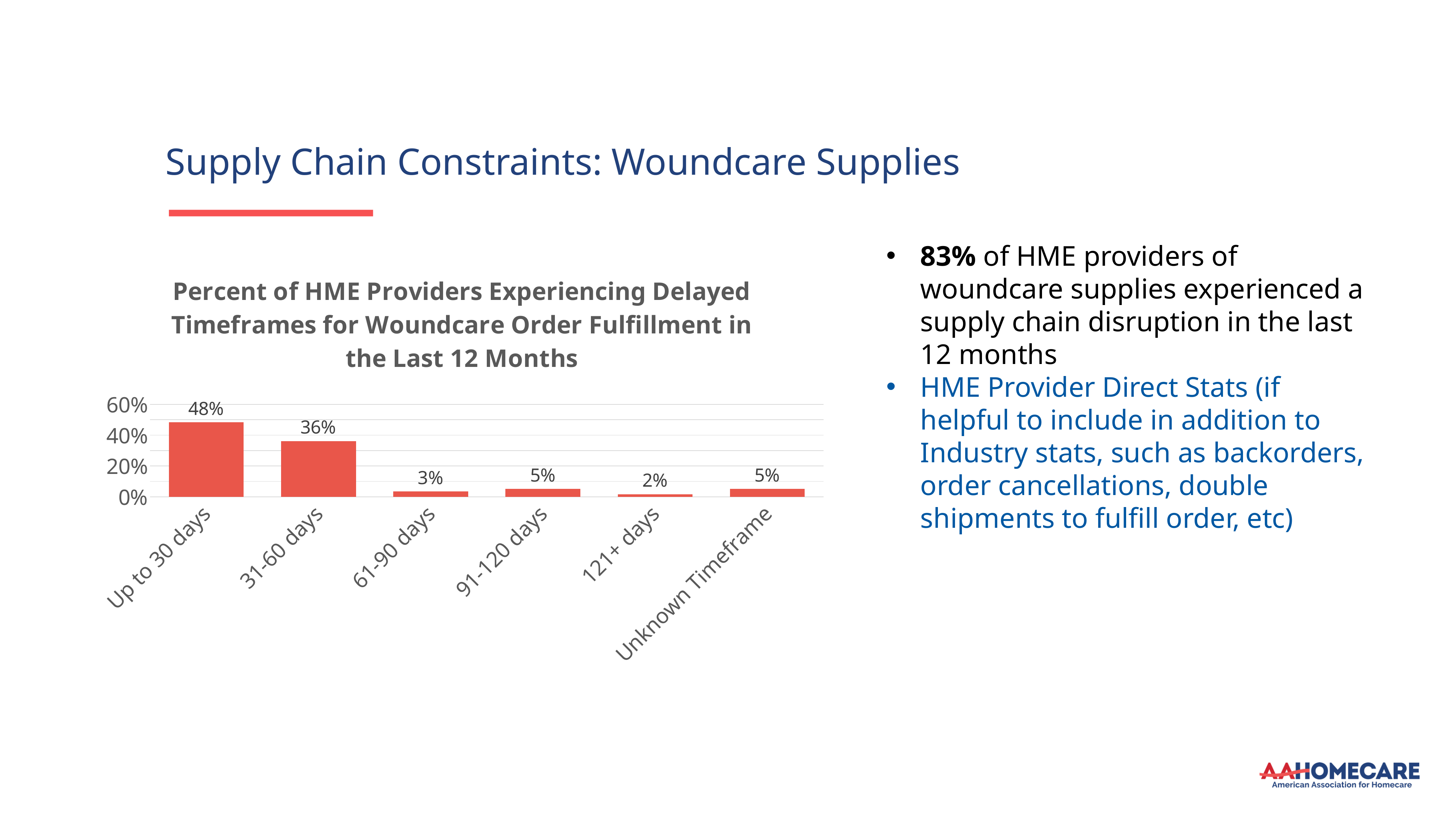
What is the value for the Unknown Timeframe category? 5% Which is larger, the value for 61-90 days or the value for 91-120 days? 91-120 days Which category has the highest value? Up to 30 days What is the value for the 31-60 days category? 36% What percent of HME providers experienced delayed woundcare order fulfillment of up to 30 days? 48% What is the difference between the values for Up to 30 days and 31-60 days? 12% Is the value for 31-60 days greater or less than 20%? greater What is the title of the chart? Percent of HME Providers Experiencing Delayed Timeframes for Woundcare Order Fulfillment in the Last 12 Months How many categories are shown on the x axis of the chart? 6 Which category has the lowest value? 121+ days What kind of chart is shown on the slide? Bar chart What is the value for the 121+ days category? 2%